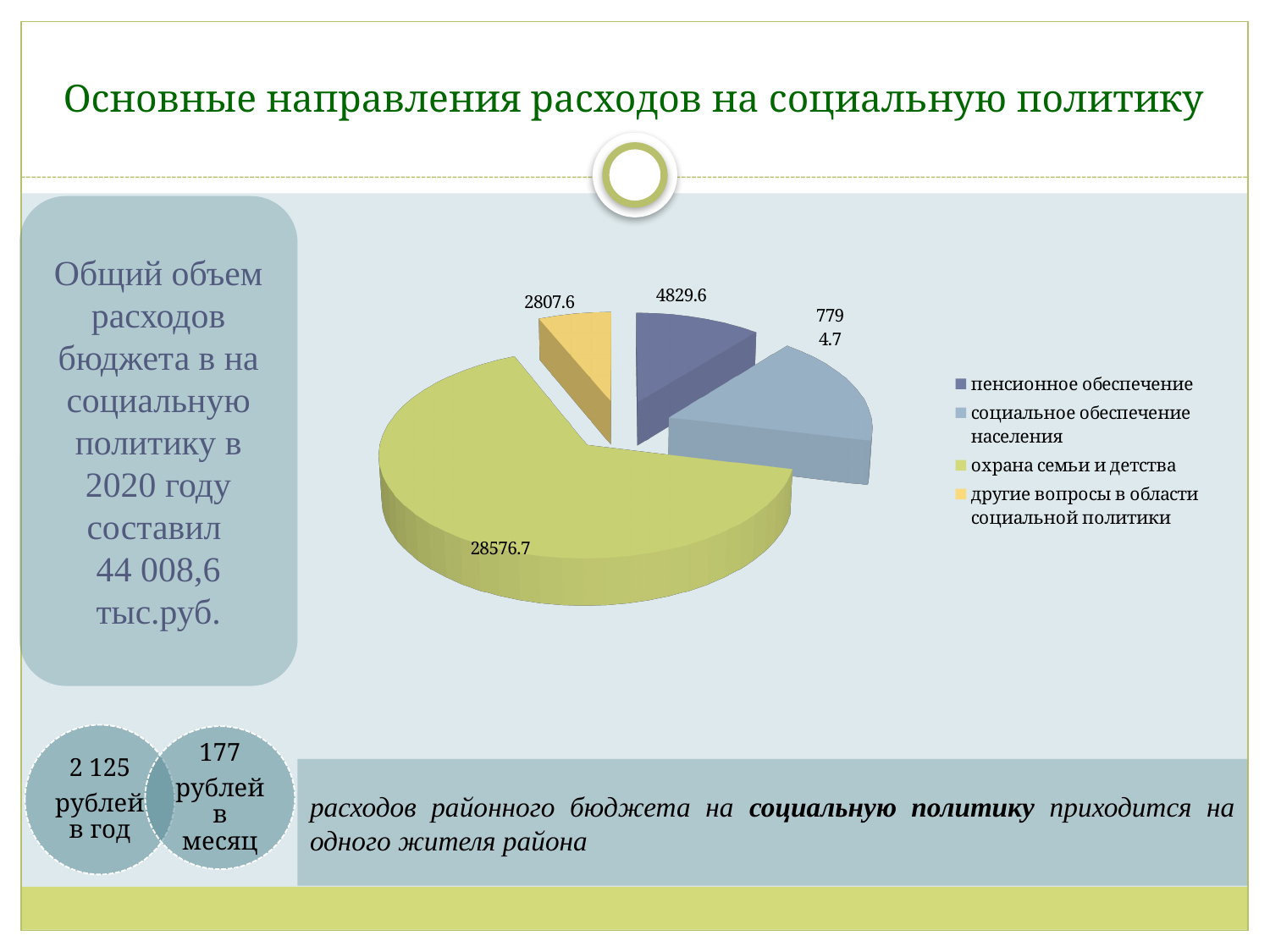
How many slices does the pie chart have? 4 What type of chart is shown on the slide? pie chart What is the difference between the values for "охрана семьи и детства" and "пенсионное обеспечение"? 23747.1 What is the value for "пенсионное обеспечение" in the pie chart? 4829.6 What is the value for "другие вопросы в области социальной политики" in the pie chart? 2807.6 What is the difference between the values for "пенсионное обеспечение" and "другие вопросы в области социальной политики"? 2022.0 Which is larger in the pie chart: "пенсионное обеспечение" or "социальное обеспечение населения"? социальное обеспечение населения Which category has the largest slice in the pie chart? охрана семьи и детства What colour is the slice for "охрана семьи и детства" in the pie chart? green (yellow-green) How many entries does the legend of the pie chart list? 4 Which category has the smallest slice in the pie chart? другие вопросы в области социальной политики What is the value for "охрана семьи и детства" in the pie chart? 28576.7